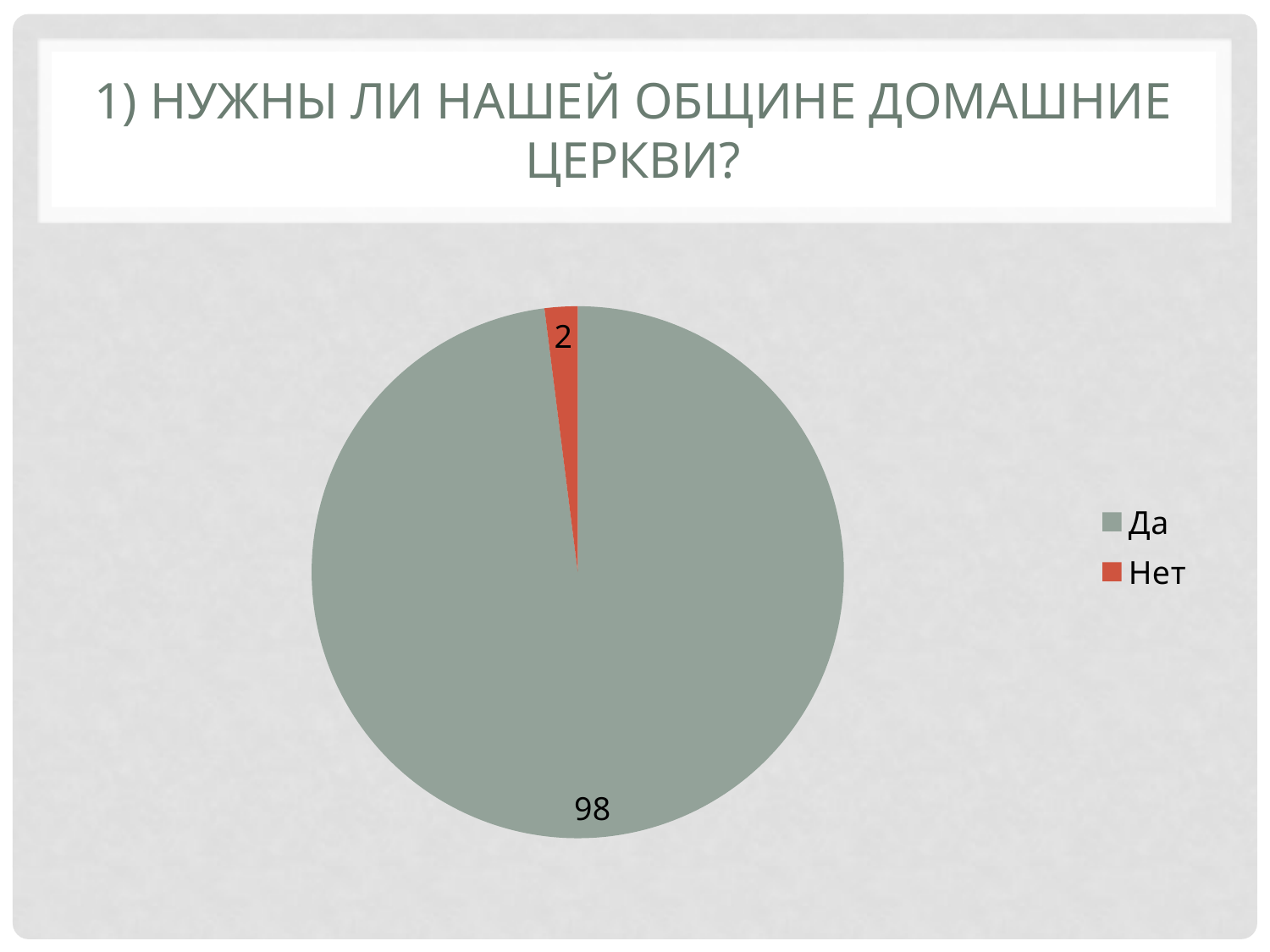
What colour is the Нет slice? red What share of the pie does the Нет slice represent? 2% What kind of chart is shown on the slide? pie chart How many slices does the pie chart have? 2 What is the difference between the values for Да and Нет? 96 What is the value for Да? 98 How many entries does the legend list? 2 Which category has the largest slice? Да Which is larger, the value for Да or the value for Нет? Да What is the total of the two slice values? 100 Which category has the smallest slice? Нет What is the value for Нет? 2